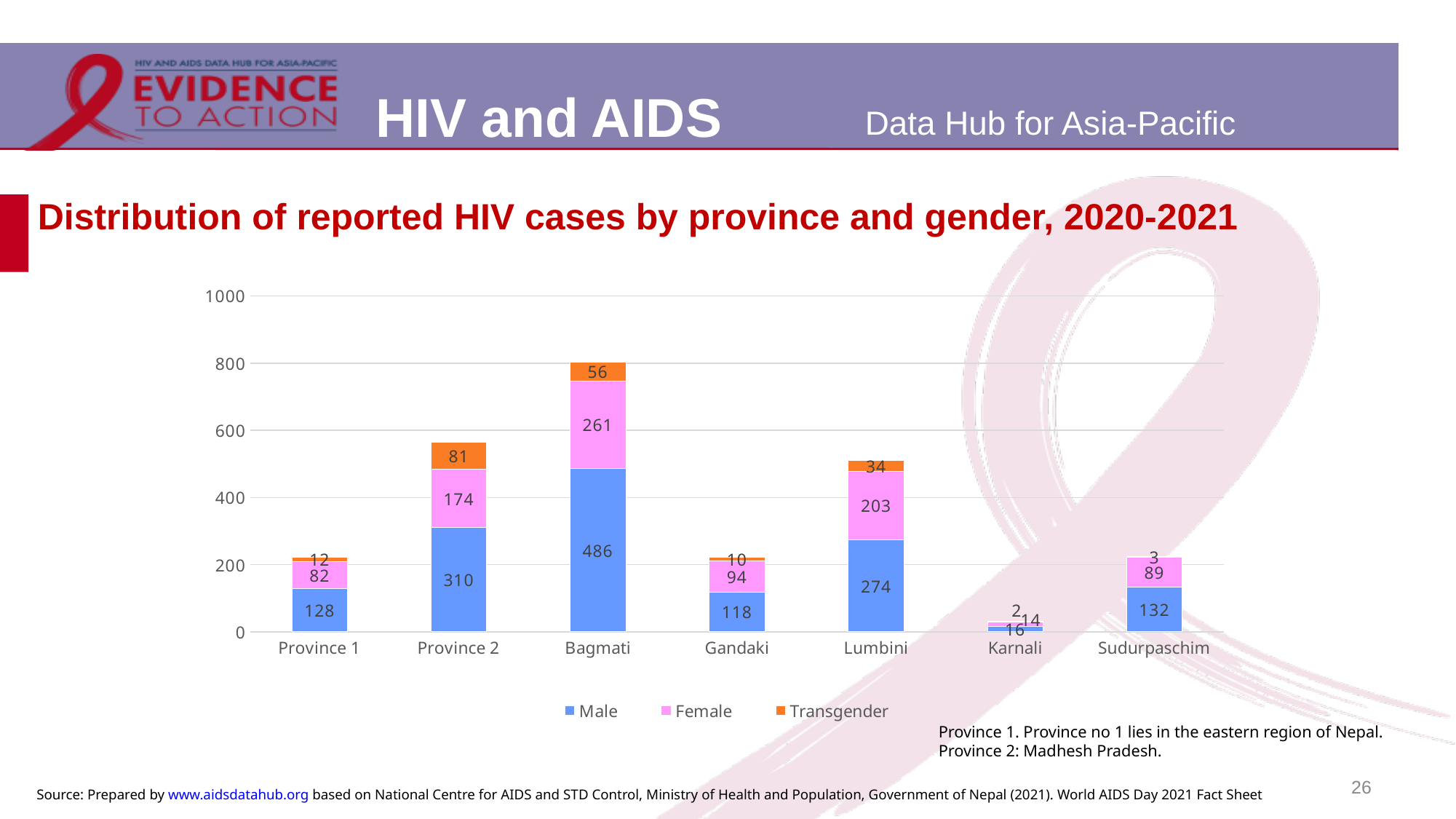
Is the total height of the Province 2 bar greater or less than 400? greater What is the Male value for Bagmati? 486 What is the total of the stacked bar for Bagmati? 803 Which province has the tallest stacked bar overall? Bagmati What is the Female value for Lumbini? 203 What kind of chart is shown on the slide? Stacked bar chart How many provinces are shown on the x axis? 7 What is the difference between the Male value for Province 2 and the Male value for Province 1? 182 How many series does the legend list? 3 Which province has the shortest stacked bar overall? Karnali Which is larger, the Female value for Bagmati or the Female value for Province 2? Bagmati What is the Transgender value for Province 2? 81